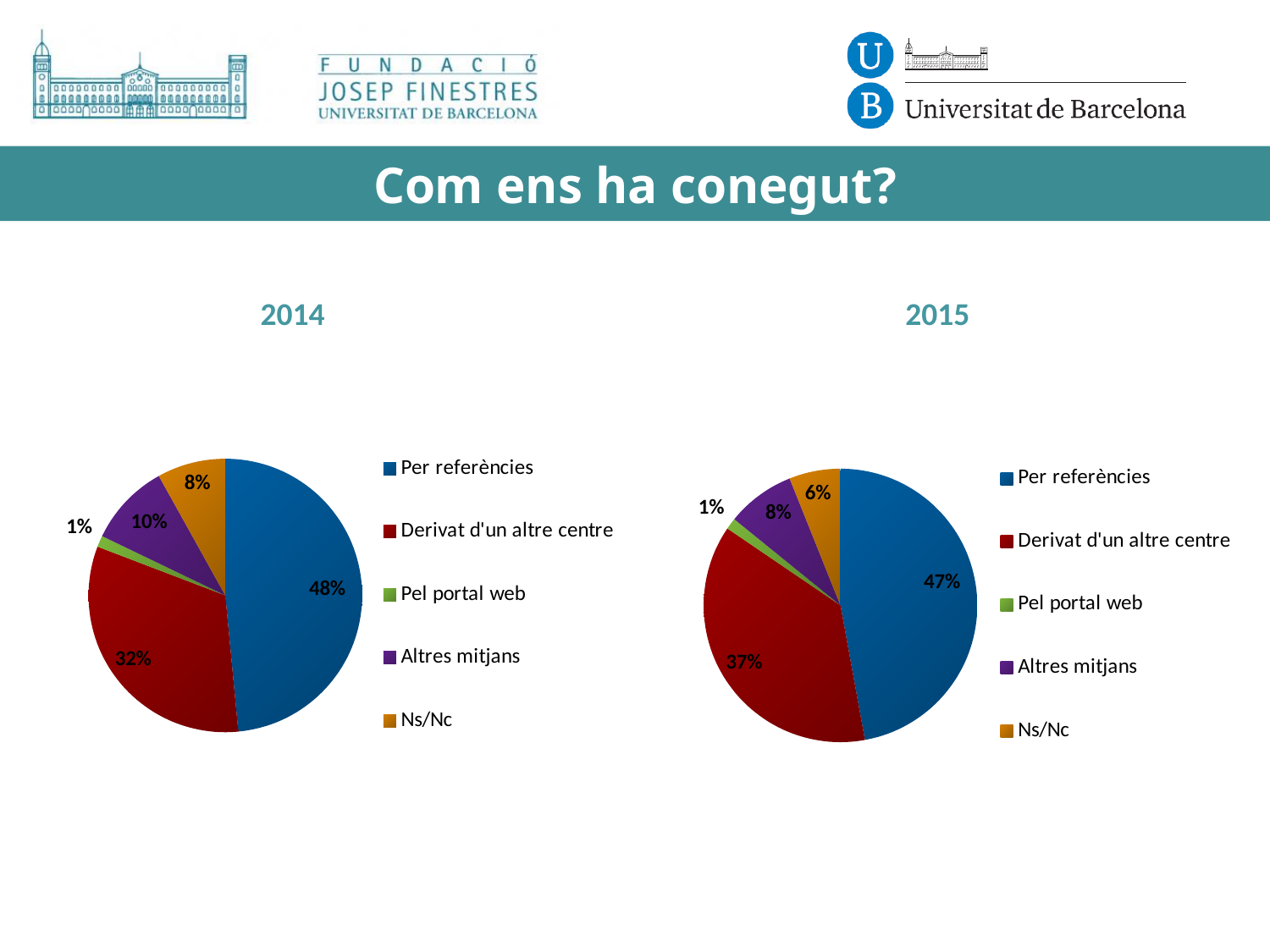
How many categories does the legend of the 2014 pie chart list? 5 In the 2014 pie chart, what is the difference in percentage points between Per referències and Derivat d'un altre centre? 16 In the 2014 pie chart, which category has the smallest slice? Pel portal web What is the title shown above the two charts on the slide? Com ens ha conegut? What type of chart is used for the 2015 data? Pie chart In the 2015 pie chart, which is larger: Altres mitjans or Ns/Nc? Altres mitjans In the 2015 pie chart, what share is labelled for Ns/Nc? 6% In the 2014 pie chart, what share is labelled for Altres mitjans? 10% In the 2015 pie chart, what share is labelled for Derivat d'un altre centre? 37% In the 2015 pie chart, what share is labelled for Pel portal web? 1% In the 2015 pie chart, which category has the largest slice? Per referències In the 2014 pie chart, what share is labelled for Per referències? 48%